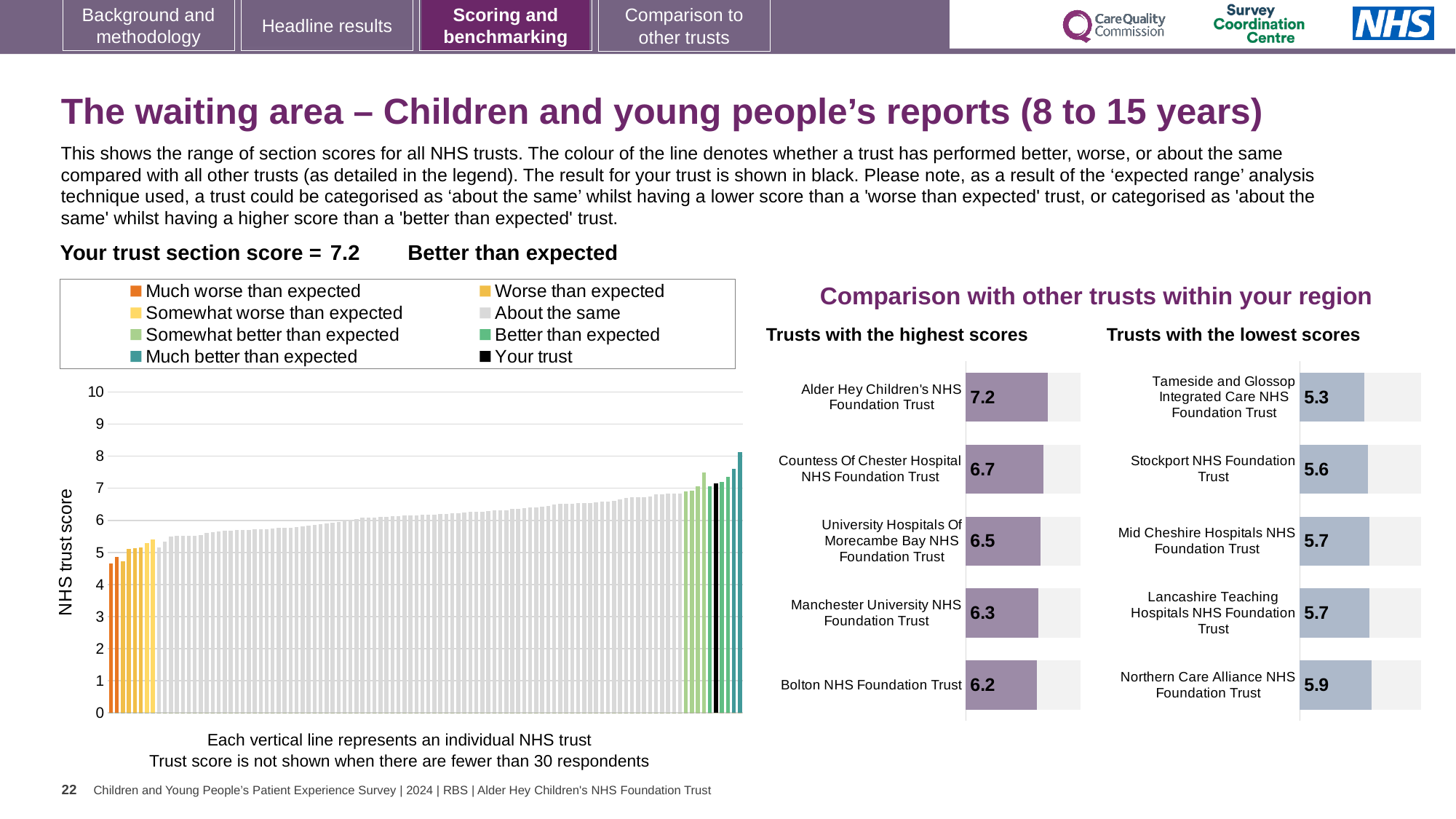
How many trusts are shown in the 'Trusts with the highest scores' chart? 5 In the 'Trusts with the lowest scores' chart, what is the difference between the scores of Northern Care Alliance NHS Foundation Trust and Tameside and Glossop Integrated Care NHS Foundation Trust? 0.6 What kind of chart is the large chart on the left showing NHS trust scores? Bar chart In the 'Trusts with the lowest scores' chart, which has the higher score: Stockport NHS Foundation Trust or Northern Care Alliance NHS Foundation Trust? Northern Care Alliance NHS Foundation Trust In the large chart on the left, is the value of the lowest bar greater or less than 5? less In the 'Trusts with the highest scores' chart, what is the difference between the scores of Alder Hey Children's NHS Foundation Trust and Countess Of Chester Hospital NHS Foundation Trust? 0.5 In the 'Trusts with the highest scores' chart, what is the score for Bolton NHS Foundation Trust? 6.2 In the 'Trusts with the lowest scores' chart, what is the score for Northern Care Alliance NHS Foundation Trust? 5.9 In the 'Trusts with the highest scores' chart, what is the score for Alder Hey Children's NHS Foundation Trust? 7.2 In the 'Trusts with the lowest scores' chart, which trust has the lowest score? Tameside and Glossop Integrated Care NHS Foundation Trust In the large chart on the left, do the trust scores rise or fall from left to right? Rise How many entries does the legend of the large chart on the left list? 8